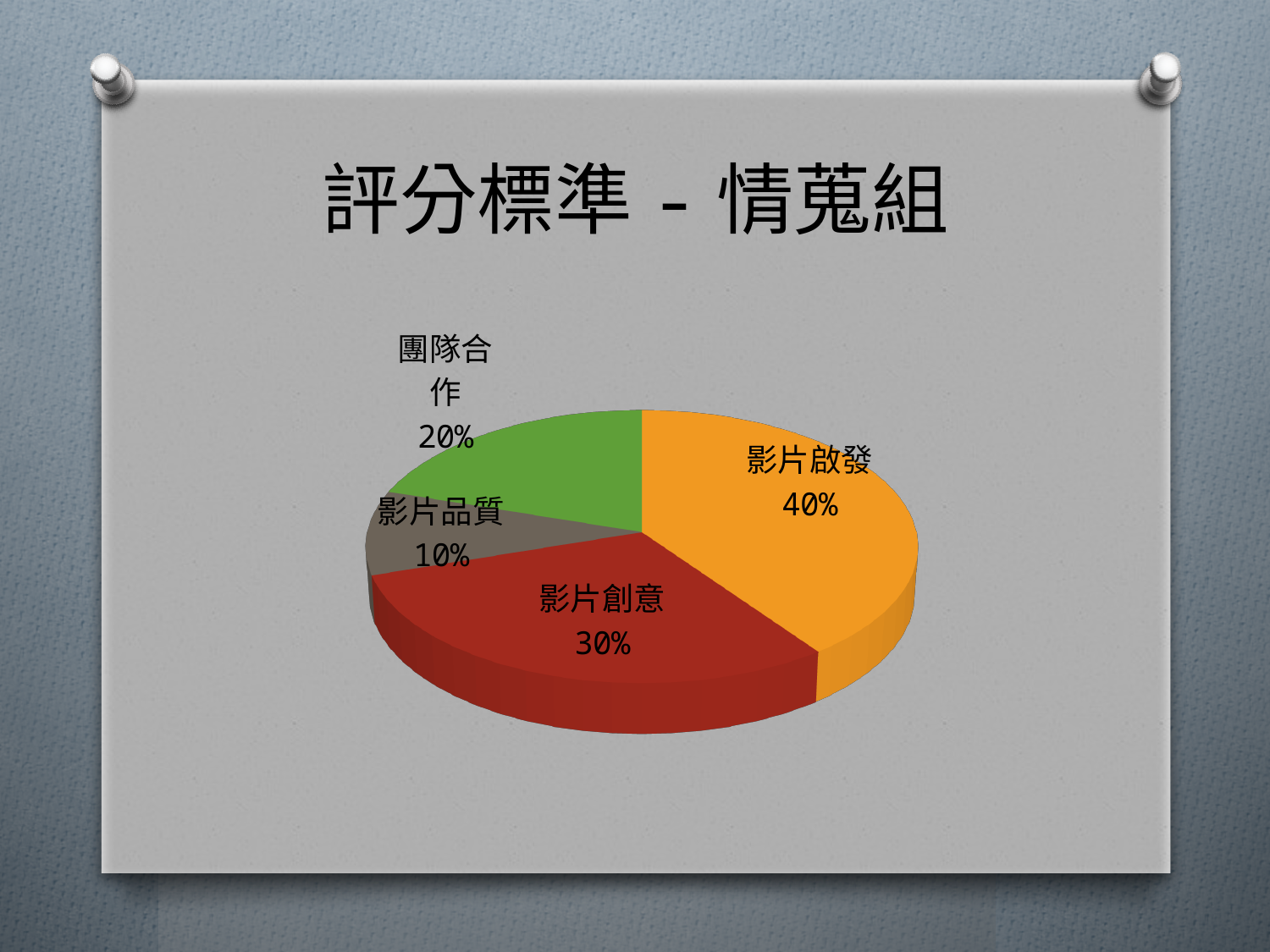
What percentage is shown for 團隊合作? 20% What kind of chart is shown on the slide? Pie chart What percentage is shown for 影片創意? 30% What is the title of the slide containing the chart? 評分標準 - 情蒐組 What is the difference between the shares of 影片啟發 and 影片創意? 10% How many slices does the pie chart have? 4 What colour is the slice for 影片創意? Red What percentage is shown for 影片品質? 10% Which has a larger share, 團隊合作 or 影片品質? 團隊合作 Which category has the largest share of the pie? 影片啟發 What percentage is shown for 影片啟發? 40% Which category has the smallest share of the pie? 影片品質